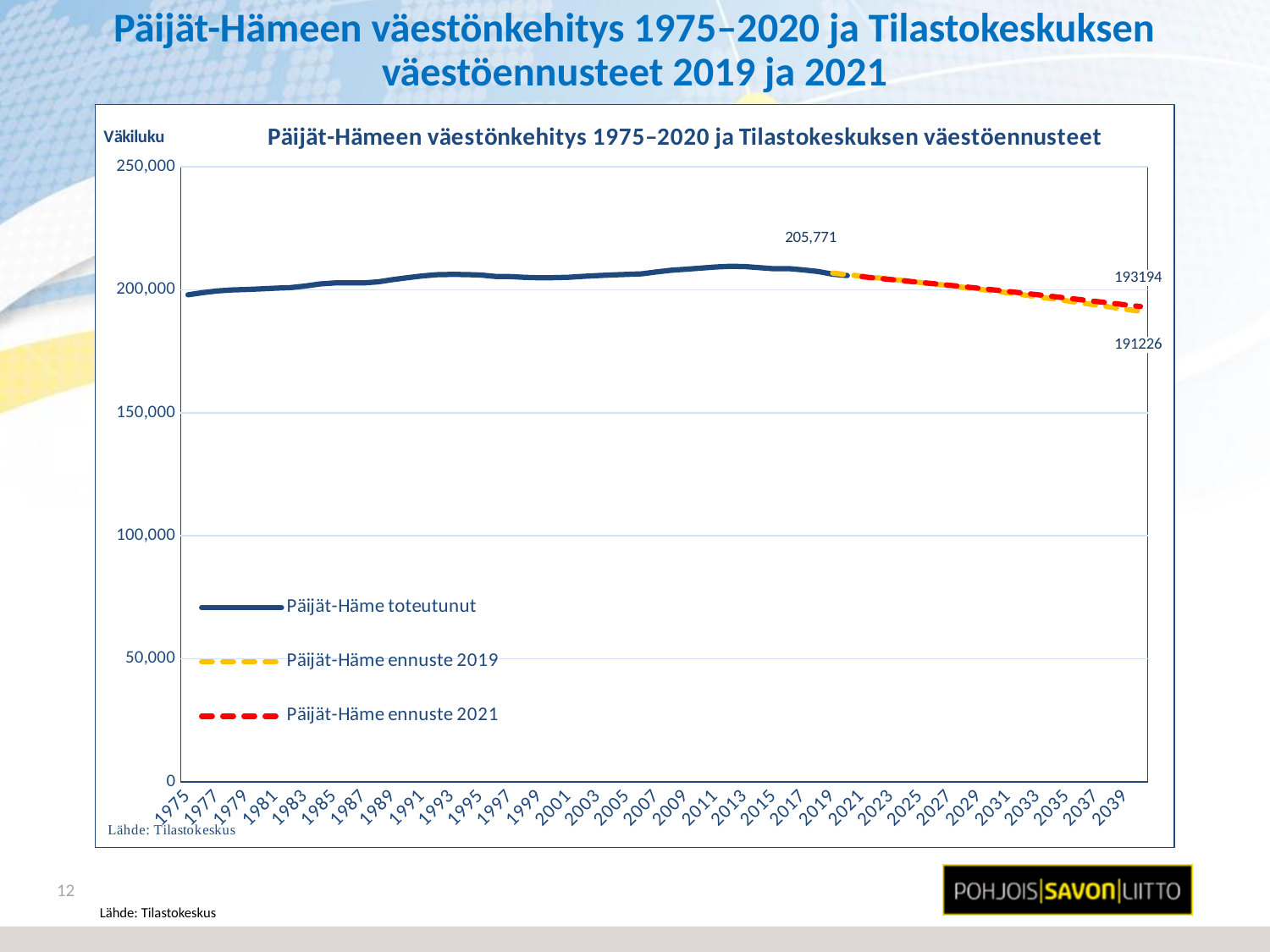
How many series does the chart legend list? 3 Which forecast series ends at a higher value, Päijät-Häme ennuste 2019 or Päijät-Häme ennuste 2021? Päijät-Häme ennuste 2021 Is the value of the Päijät-Häme ennuste 2019 series in 2039 greater or less than 200,000? less What is the difference between the labelled end values of the ennuste 2021 and ennuste 2019 series? 1968 What is the label shown on the vertical axis of the chart? Väkiluku What is the labelled end value of the Päijät-Häme ennuste 2021 series? 193194 Do the forecast series rise or fall from 2021 to 2039? fall What colour is the Päijät-Häme ennuste 2021 line in the legend? red What kind of chart is shown on the slide? line chart Is the value of the Päijät-Häme toteutunut series in 1975 greater or less than 150,000? greater What is the labelled value at the end of the Päijät-Häme toteutunut series? 205,771 What is the labelled end value of the Päijät-Häme ennuste 2019 series? 191226